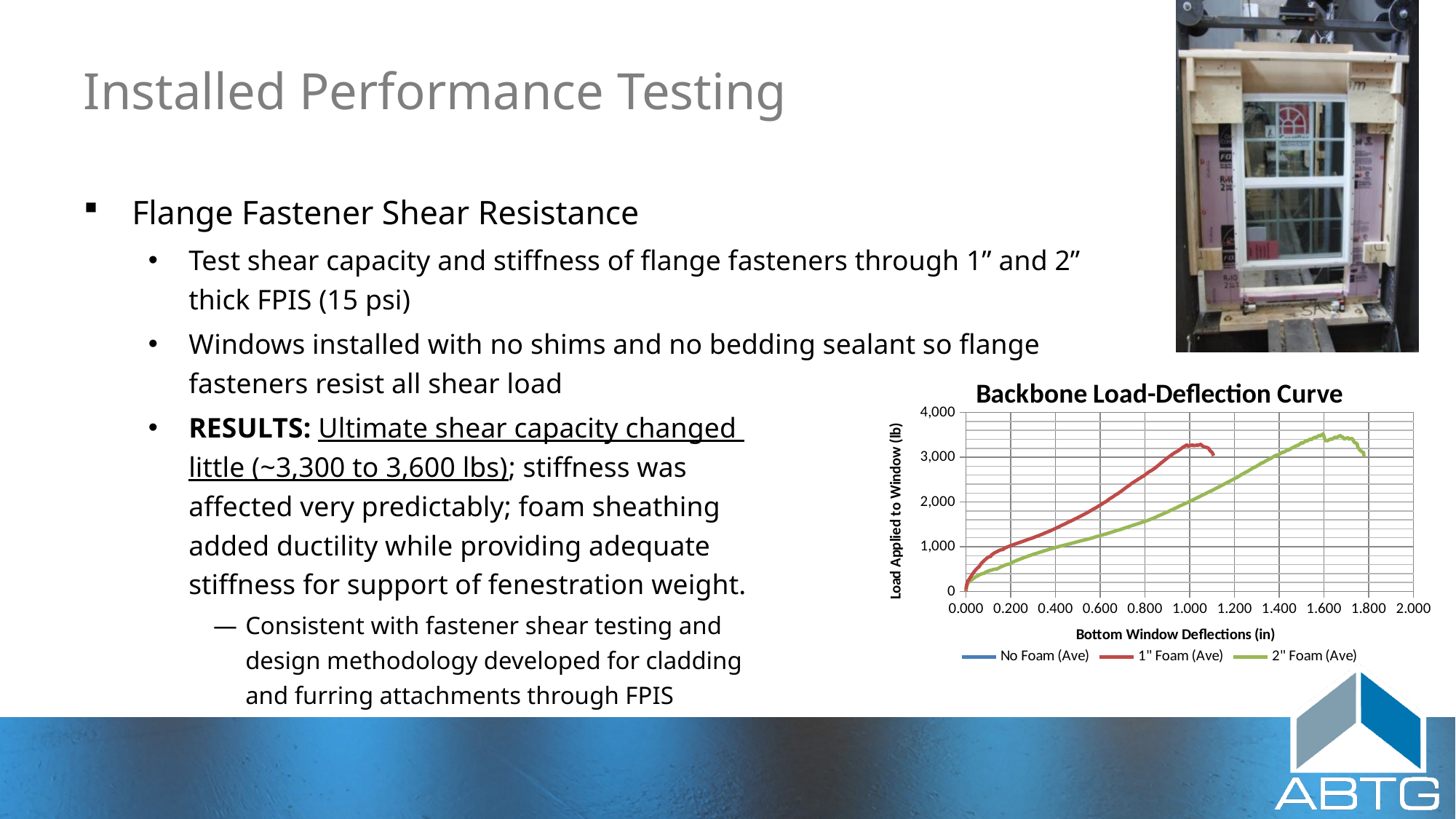
In the Backbone Load-Deflection Curve chart, which series reaches the larger maximum deflection, 1" Foam (Ave) or 2" Foam (Ave)? 2" Foam (Ave) What is the title of the chart on the slide? Backbone Load-Deflection Curve In the Backbone Load-Deflection Curve chart, does the load for the 2" Foam (Ave) series generally rise or fall as deflection increases from 0.000 to 1.600 in? Rise In the Backbone Load-Deflection Curve chart, at a deflection of 0.400 in, is the load for the 1" Foam (Ave) series greater or less than 1,000? greater What kind of chart is the Backbone Load-Deflection Curve? Line chart In the Backbone Load-Deflection Curve chart, is the peak load for the 1" Foam (Ave) series greater or less than 3,000? greater What is the label of the vertical axis of the Backbone Load-Deflection Curve chart? Load Applied to Window (lb) In the Backbone Load-Deflection Curve chart, is the maximum deflection reached by the 1" Foam (Ave) series greater or less than 1.200 in? less How many series does the legend of the Backbone Load-Deflection Curve chart list? 3 In the Backbone Load-Deflection Curve chart, at a deflection of 0.800 in, which series shows the higher load, 1" Foam (Ave) or 2" Foam (Ave)? 1" Foam (Ave)